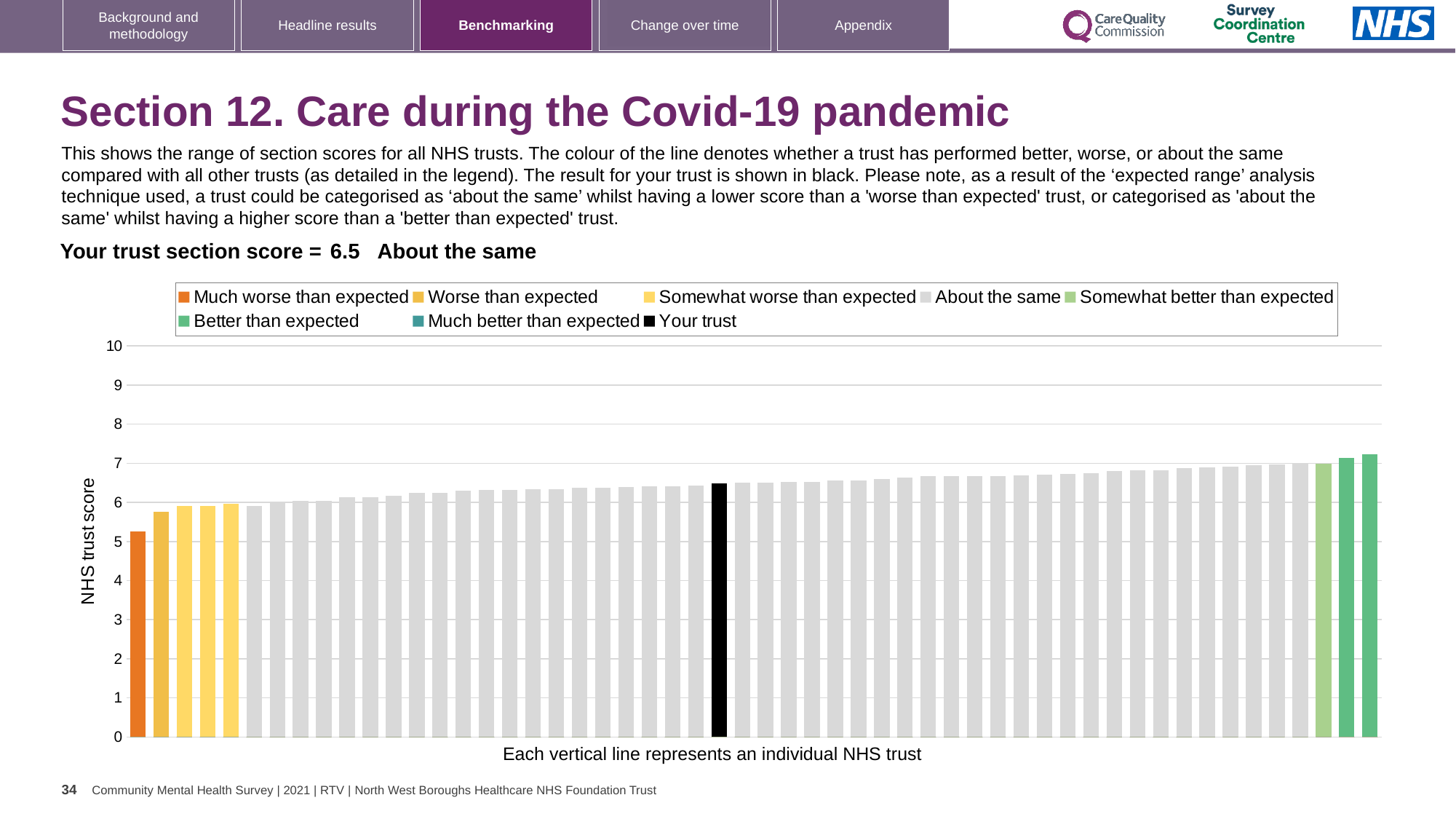
How is your trust categorised compared with other trusts for this section? About the same Which legend category does the lowest bar on the chart belong to? Much worse than expected How many entries does the chart legend list? 8 What colour is used for the 'Your trust' bar? black What kind of chart is shown on the slide? bar chart How many bars are coloured orange ('Much worse than expected')? 1 Is the value for the orange 'Much worse than expected' bar greater or less than 6? less Is the value of the tallest bar on the chart greater or less than 7? greater Do the bar values rise or fall moving from left to right along the x axis? rise What is the section score for your trust shown on the slide? 6.5 Is the value for your trust (the black bar) greater or less than 6? greater Which legend category does the highest bar on the chart belong to? Better than expected